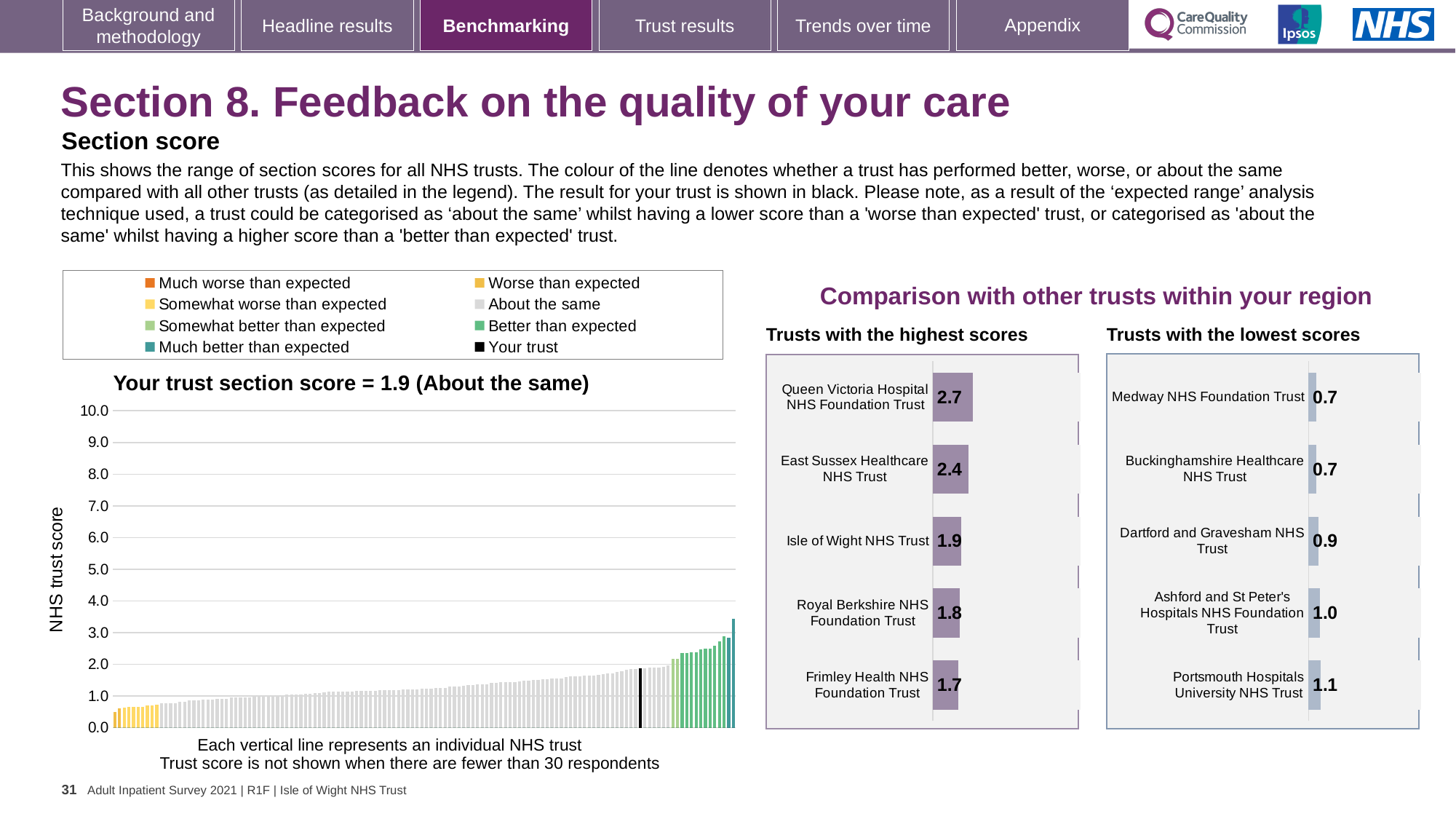
In the 'Trusts with the lowest scores' chart, how many trusts are shown? 5 In the 'Trusts with the lowest scores' chart, which trust has the highest score? Portsmouth Hospitals University NHS Trust In the 'Your trust section score' chart, do the trust scores rise or fall from left to right? rise In the 'Trusts with the lowest scores' chart, which has the larger score: Dartford and Gravesham NHS Trust or Ashford and St Peter's Hospitals NHS Foundation Trust? Ashford and St Peter's Hospitals NHS Foundation Trust In the 'Your trust section score' chart, is the value of the tallest bar greater or less than 3.0? greater In the 'Your trust section score' chart, what colour is used for 'Your trust' in the legend? black In the 'Trusts with the highest scores' chart, which trust has the lowest score? Frimley Health NHS Foundation Trust What kind of chart is the 'Your trust section score' chart? bar chart In the 'Trusts with the highest scores' chart, what is the difference between the scores of Queen Victoria Hospital NHS Foundation Trust and Frimley Health NHS Foundation Trust? 1.0 In the 'Your trust section score' chart, how many entries does the legend list? 8 In the 'Your trust section score' chart, what is the section score for your trust? 1.9 In the 'Trusts with the highest scores' chart, what is the score for Queen Victoria Hospital NHS Foundation Trust? 2.7